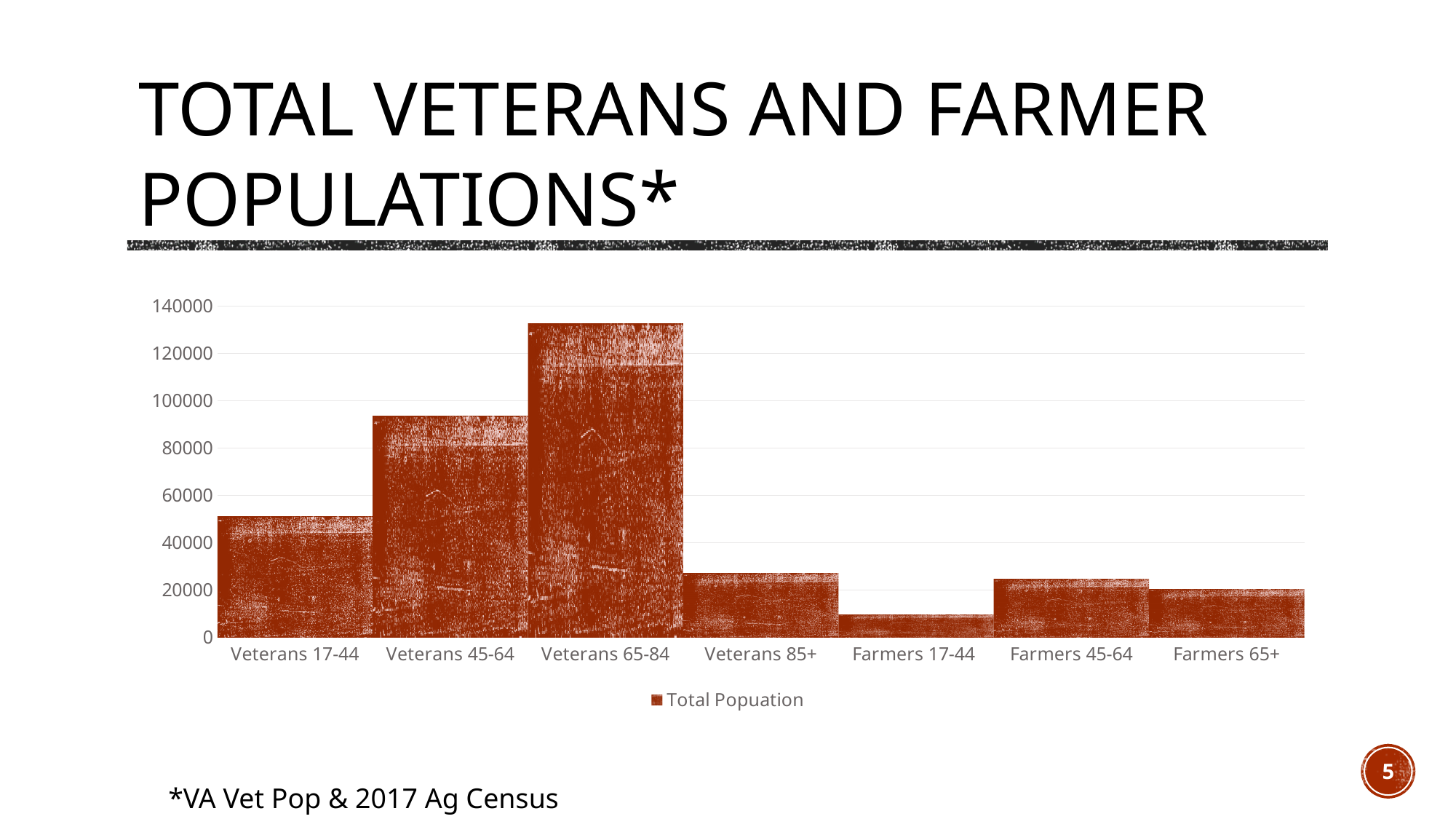
Which is larger, the value for Farmers 45-64 or the value for Farmers 17-44? Farmers 45-64 What type of chart is shown on the slide? bar chart Which category has the lowest value in the chart? Farmers 17-44 How many series does the chart legend list? 1 Is the value for Veterans 17-44 greater or less than 40000? greater How many categories are shown on the x axis of the chart? 7 Is the value for Farmers 17-44 greater or less than 20000? less Which is larger, the value for Veterans 45-64 or the value for Veterans 17-44? Veterans 45-64 Is the value for Veterans 65-84 greater or less than 120000? greater What is the name of the series shown in the chart legend? Total Popuation Which category has the highest value in the chart? Veterans 65-84